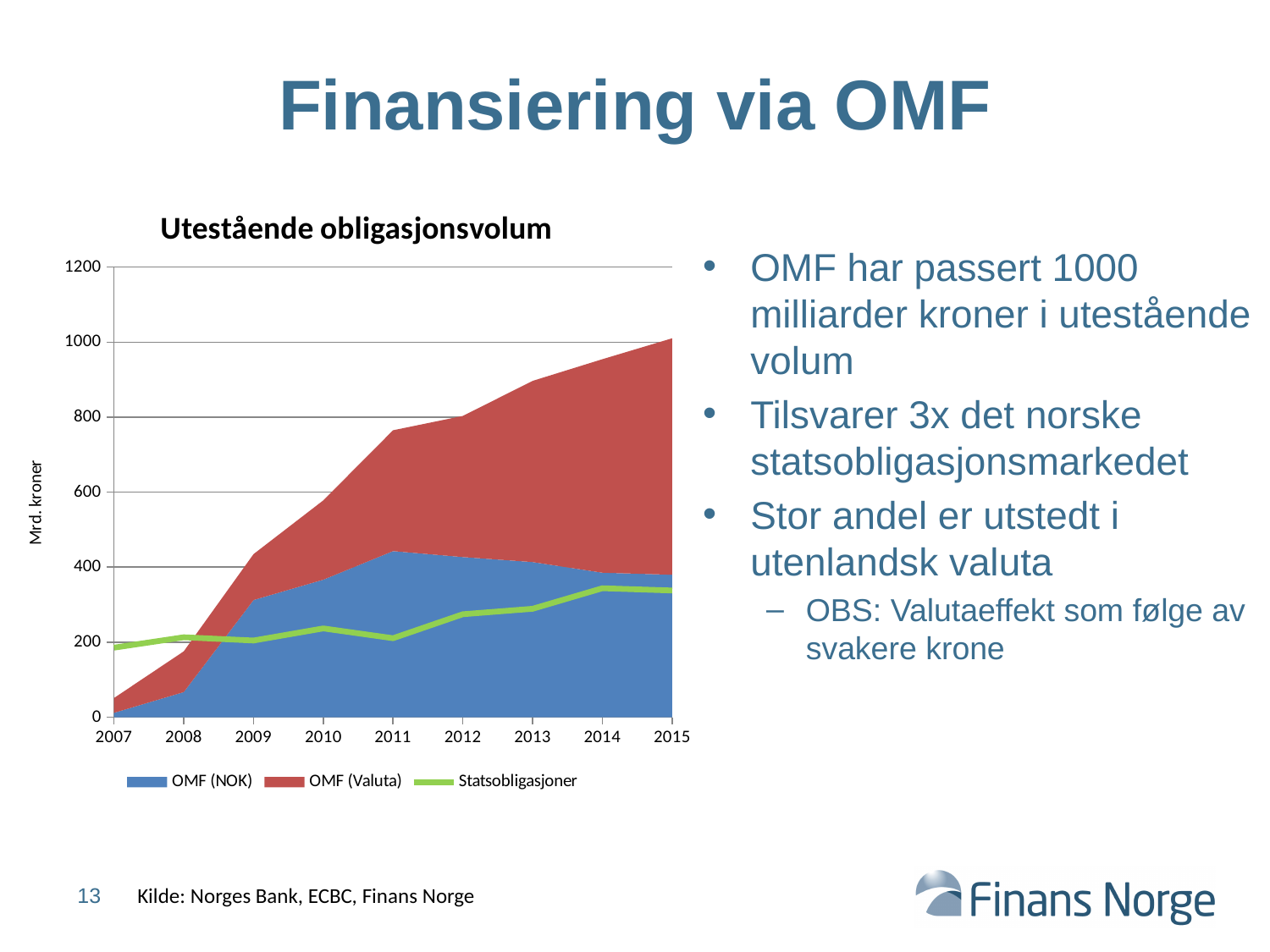
Is the value for OMF (NOK) in 2011 greater or less than 400? greater Is the value for Statsobligasjoner in 2015 greater or less than 200? greater What kind of chart is shown on the slide? combination area and line chart In which year is the total stacked OMF volume highest? 2015 How many years are shown along the x axis of the chart? 9 What is the title of the chart? Utestående obligasjonsvolum What is the label on the vertical axis of the chart? Mrd. kroner Does the Statsobligasjoner line generally rise or fall from 2007 to 2015? rise Is the total stacked OMF volume in 2015 greater or less than 800? greater How many series does the chart legend list? 3